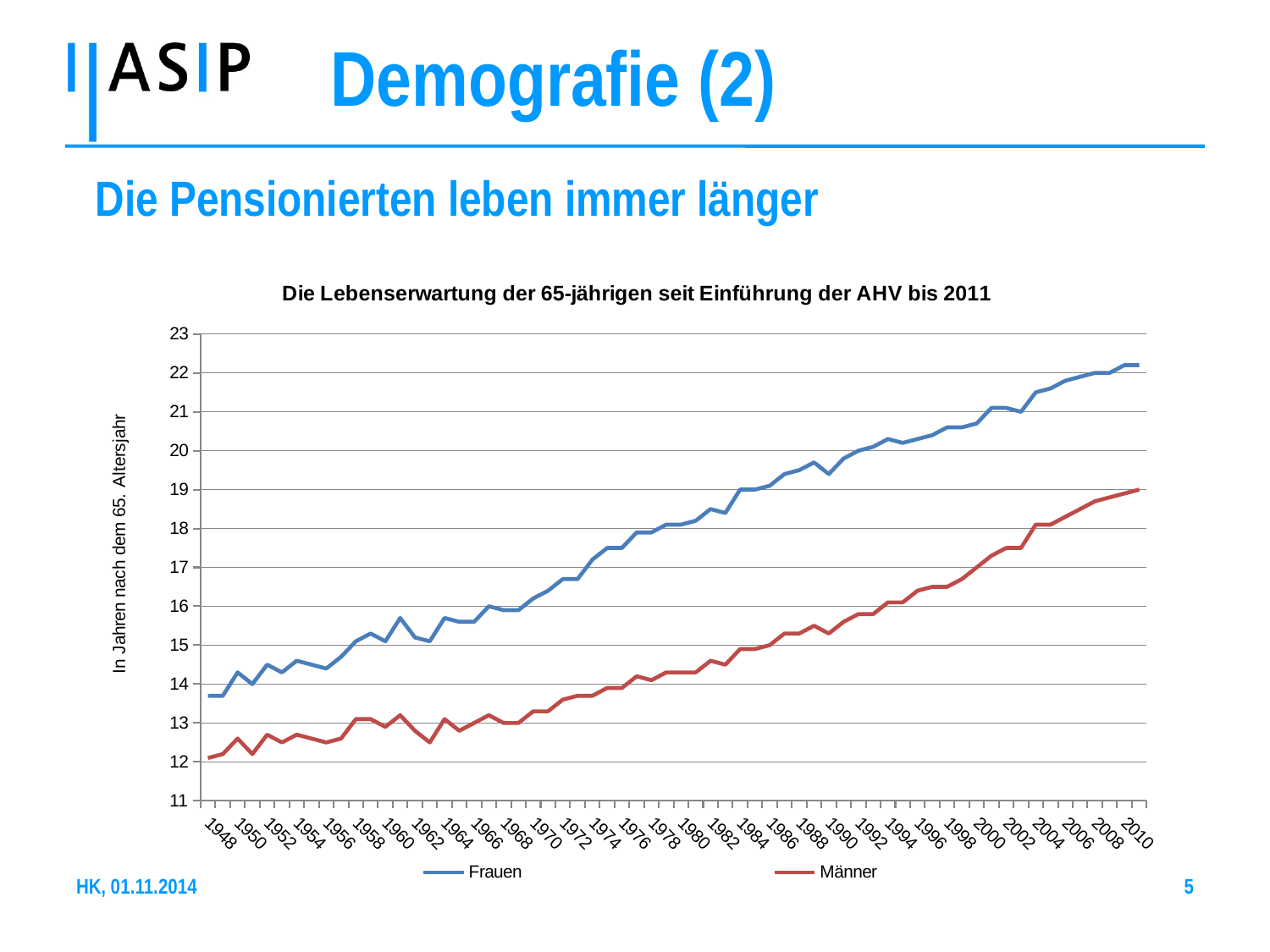
Which series has the higher value in 2010, Frauen or Männer? Frauen Do the values for Frauen rise or fall from 1948 to 2010? rise Is the value for Frauen in 2010 greater or less than 21? greater Is the value for Frauen in 1948 greater or less than 14? less What kind of chart is shown on the slide? line chart Is the value for Männer in 2010 greater or less than 18? greater What is the title of the chart? Die Lebenserwartung der 65-jährigen seit Einführung der AHV bis 2011 Do the values for Männer rise or fall from 1948 to 2010? rise What are the two series named in the legend? Frauen and Männer How many series does the legend list? 2 Which series has the lower value in 1948, Frauen or Männer? Männer